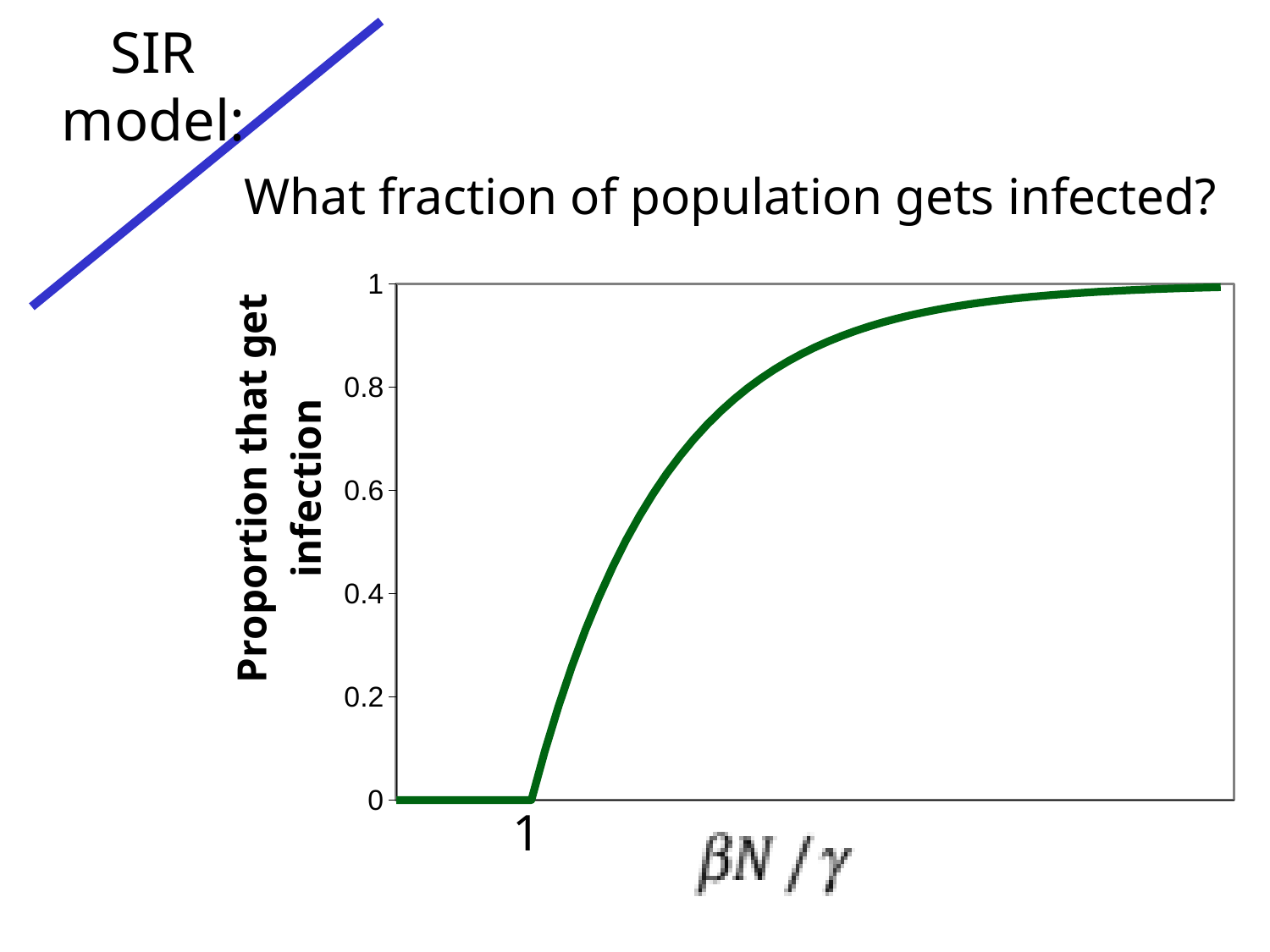
What is the value of the curve at βN / γ = 1? 0 What is the highest tick value shown on the y axis? 1 Does the curve rise or fall as βN / γ increases beyond 1? rise Is the value of the curve at the right edge of the chart greater or less than 0.8? greater How many lines are plotted on the chart? 1 Is the value of the curve for βN / γ below 1 greater or less than 0.2? less Which x-axis tick value is labelled on the chart? 1 What is the label of the x axis of the chart? βN / γ How many tick labels are shown on the y axis? 6 What is the label of the y axis of the chart? Proportion that get infection What kind of chart is shown on the slide? line chart What is the lowest value the curve takes? 0